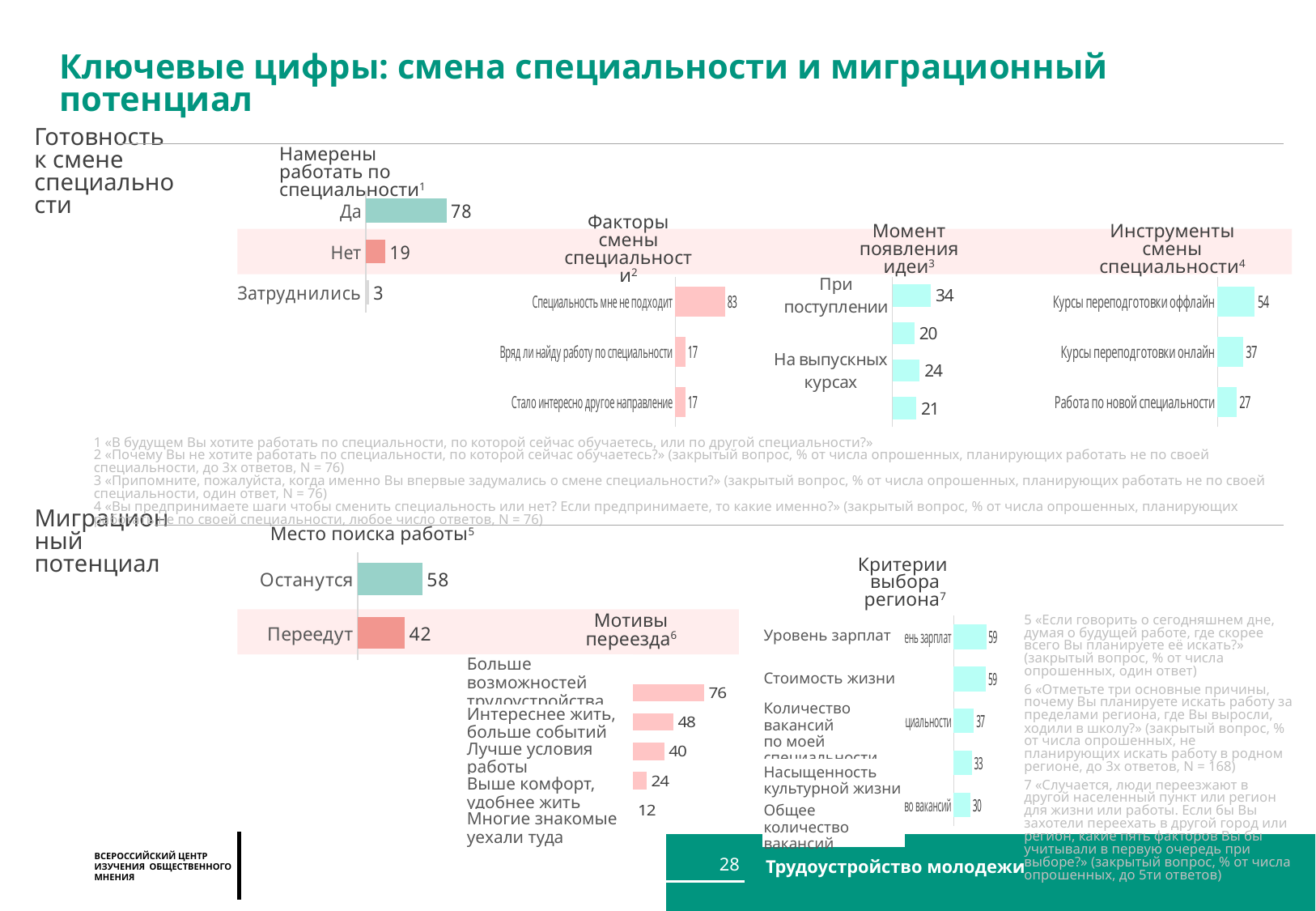
In the chart 'Факторы смены специальности', what is the value for 'Стало интересно другое направление'? 17 In the chart 'Намерены работать по специальности', what is the value for 'Нет'? 19 In the chart 'Место поиска работы', what is the value for 'Переедут'? 42 In the chart 'Инструменты смены специальности', which tool has the lowest value? Работа по новой специальности How many categories are shown in the chart 'Мотивы переезда'? 5 In the chart 'Намерены работать по специальности', what is the difference between 'Да' and 'Нет'? 59 In the chart 'Факторы смены специальности', which factor has the highest value? Специальность мне не подходит In the chart 'Мотивы переезда', what is the value for 'Больше возможностей трудоустройства'? 76 What type of chart is 'Критерии выбора региона'? Bar chart In the chart 'Намерены работать по специальности', what is the value for 'Да'? 78 In the chart 'Инструменты смены специальности', what is the value for 'Курсы переподготовки онлайн'? 37 In the chart 'Место поиска работы', which is larger: 'Останутся' or 'Переедут'? Останутся